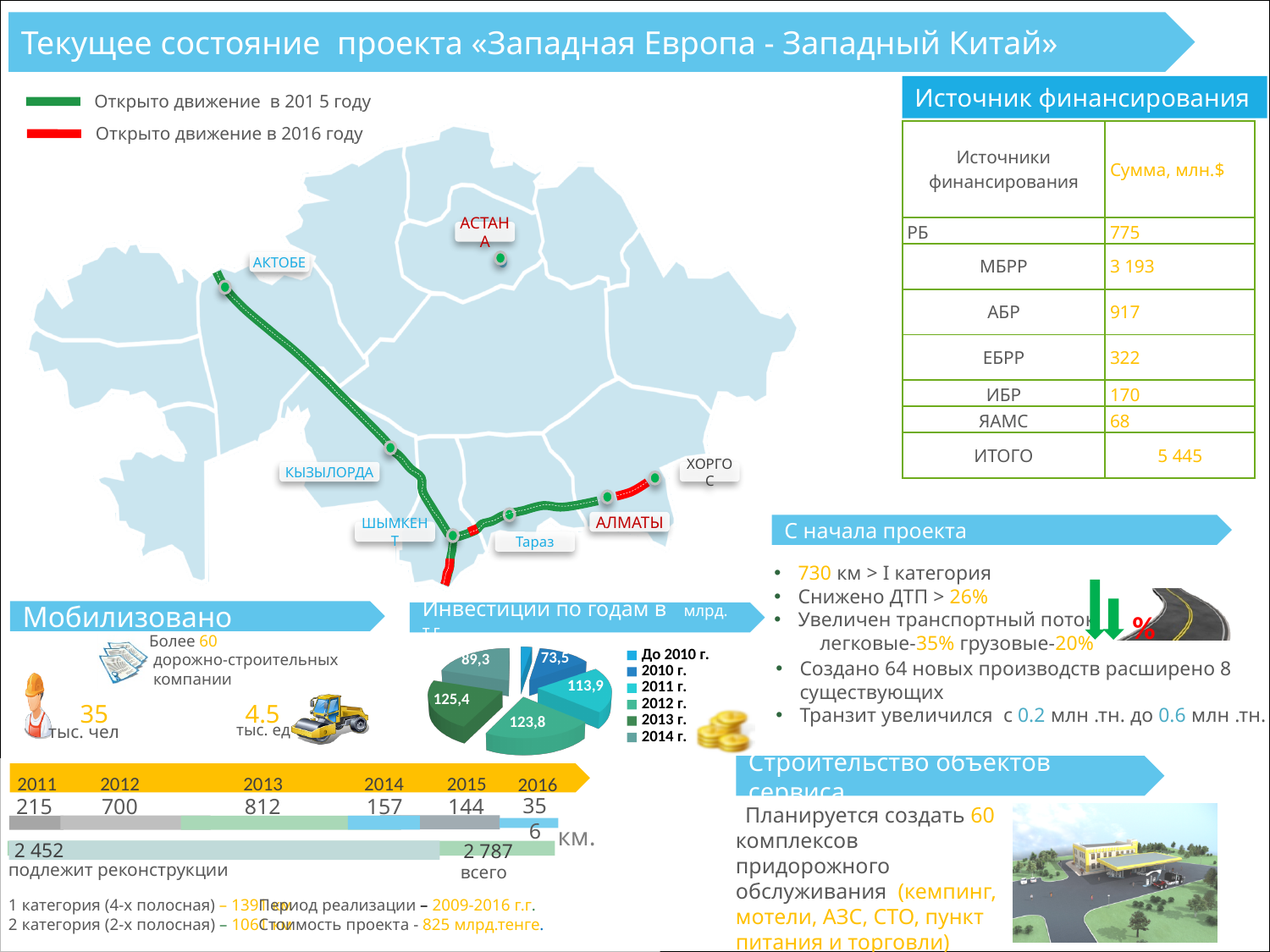
In the 'Инвестиции по годам' pie chart, what is the largest labelled slice value? 125,4 In the 'Инвестиции по годам' pie chart, what is the smallest labelled slice value? 73,5 In the bottom-left bar chart of kilometres by year, what is the difference between 2012 and 2011? 485 In the bottom-left bar chart of kilometres by year, what is the total labelled 'всего'? 2 787 What unit is given in the title of the 'Инвестиции по годам' pie chart? млрд. тг. In the bottom-left bar chart of kilometres by year, which year has the highest value? 2013 In the 'Инвестиции по годам' pie chart, which is larger: the slice labelled 113,9 or the slice labelled 89,3? 113,9 How many series does the legend of the 'Инвестиции по годам' pie chart list? 6 In the 'Инвестиции по годам' pie chart, what is the difference between the slices labelled 125,4 and 73,5? 51,9 In the bottom-left bar chart of kilometres by year, what is the value for 2011? 215 In the bottom-left bar chart of kilometres by year, what is the value for 2013? 812 What kind of chart is the 'Инвестиции по годам' chart? pie chart